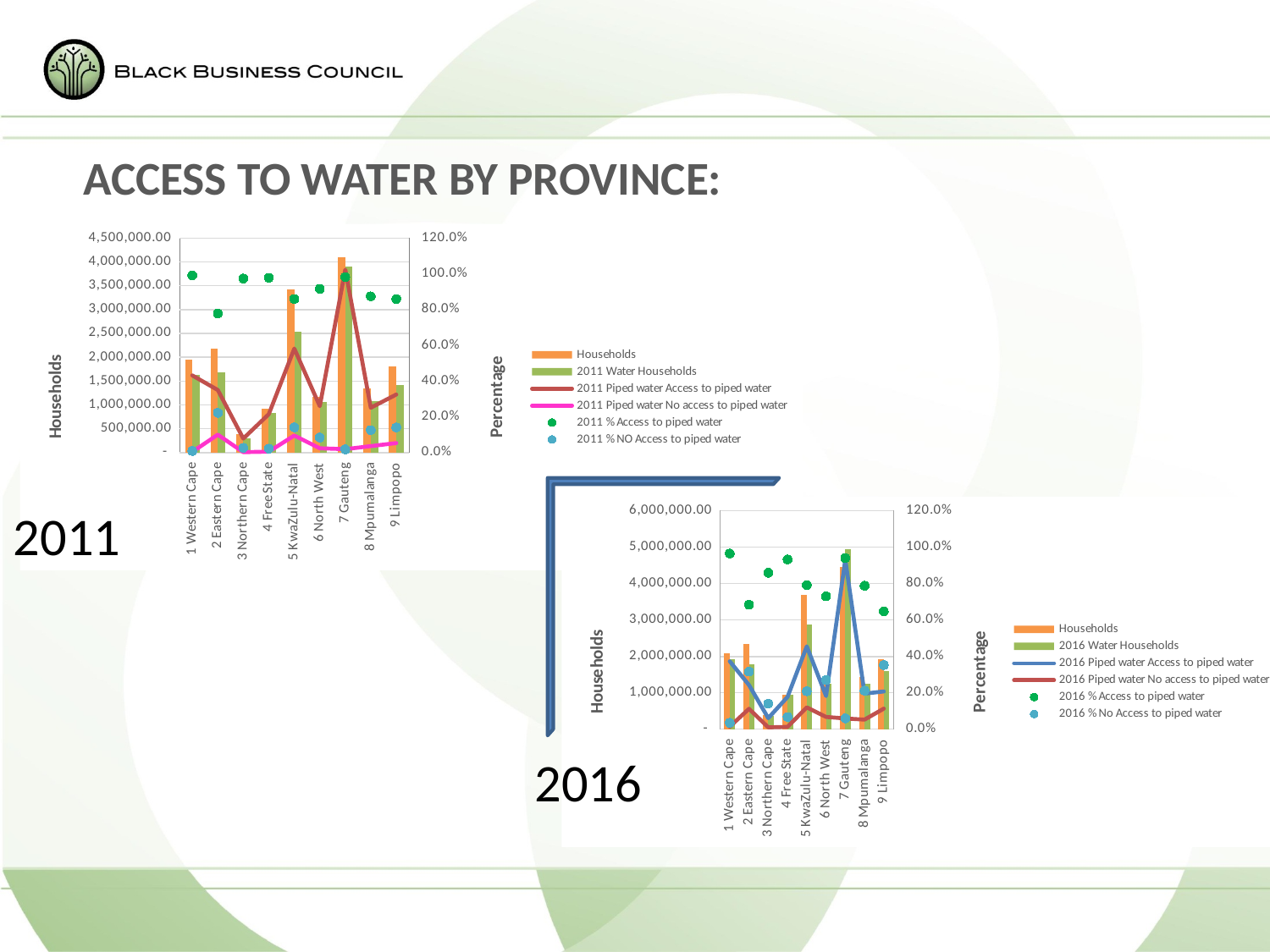
On the 2011 chart, is the Households value for 5 KwaZulu-Natal greater or less than 3,000,000.00? greater On the 2016 chart, is the Households value for 7 Gauteng greater or less than 4,000,000.00? greater How many provinces are shown on the x axis of the 2016 chart? 9 On the 2016 chart, which province has the highest Households bar? 7 Gauteng On the 2016 chart, is the Households value for 3 Northern Cape greater or less than 1,000,000.00? less How many series does the legend of the 2011 chart list? 6 On the 2011 chart, which is larger, the Households value for 7 Gauteng or for 5 KwaZulu-Natal? 7 Gauteng On the 2011 chart, which province has the lowest Households bar? 3 Northern Cape What is the title of the slide above the charts? ACCESS TO WATER BY PROVINCE: On the 2011 chart, which province has the highest Households bar? 7 Gauteng